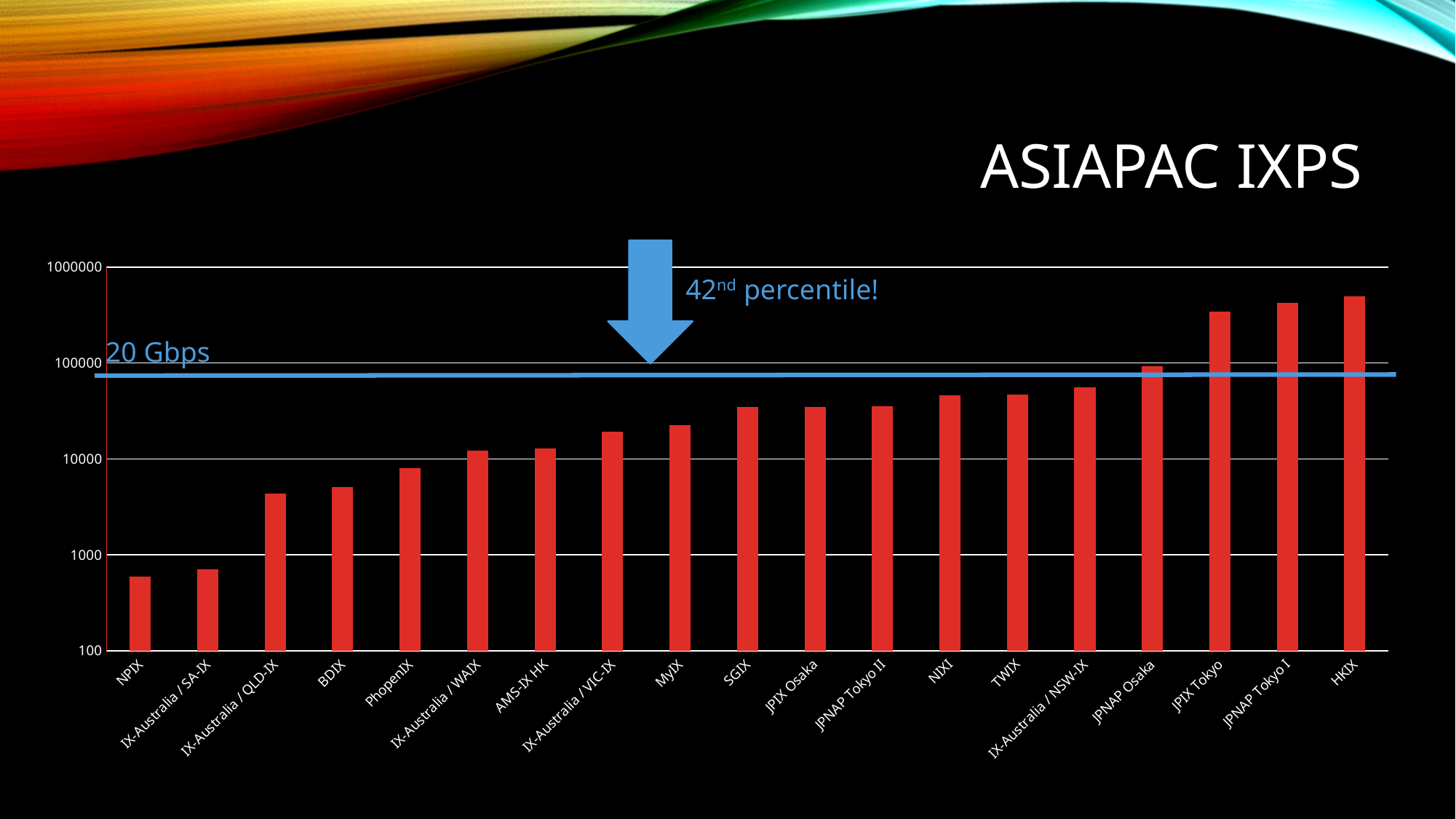
Is the value for MyIX greater or less than 10000? greater Which IXP has the lowest bar in the chart? NPIX What label is attached to the horizontal blue line drawn across the chart? 20 Gbps Do the bar values rise or fall from left to right along the x axis? rise Which has the larger value, JPIX Tokyo or BDIX? JPIX Tokyo What kind of chart is shown on the slide? bar chart Is the value for BDIX greater or less than 10000? less Which IXP has the highest bar in the chart? HKIX How many IXPs (categories) are plotted in the chart? 19 Is the value for NPIX greater or less than 1000? less What is the title of the slide? ASIAPAC IXPS